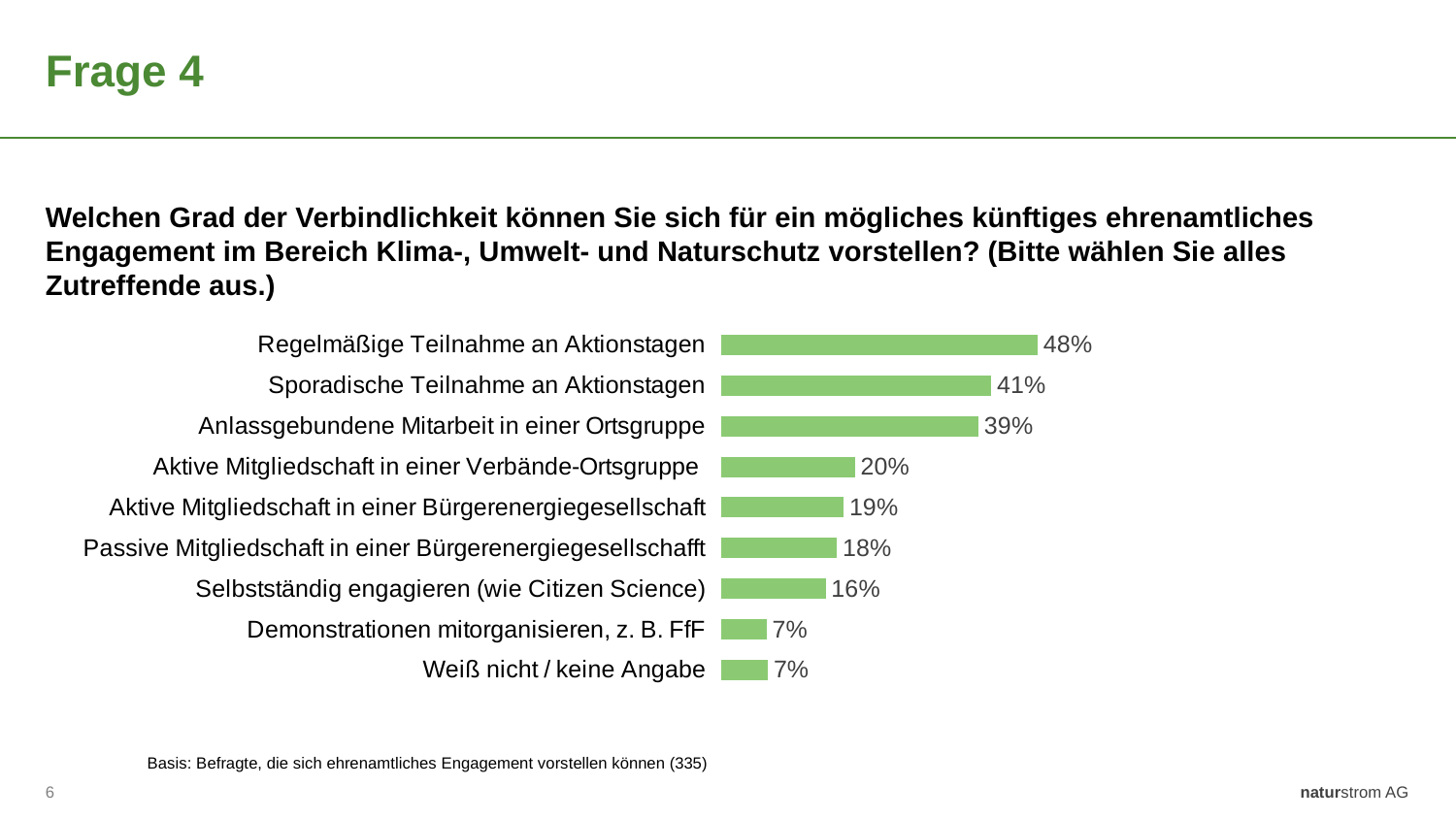
Which is larger: "Sporadische Teilnahme an Aktionstagen" or "Anlassgebundene Mitarbeit in einer Ortsgruppe"? Sporadische Teilnahme an Aktionstagen Which category has the highest value? Regelmäßige Teilnahme an Aktionstagen What is the difference between "Regelmäßige Teilnahme an Aktionstagen" and "Sporadische Teilnahme an Aktionstagen"? 7% How many categories are shown in the chart? 9 Which is larger: "Passive Mitgliedschaft in einer Bürgerenergiegesellschafft" or "Selbstständig engagieren (wie Citizen Science)"? Passive Mitgliedschaft in einer Bürgerenergiegesellschafft What is the lowest value shown in the chart? 7% What is the value for "Regelmäßige Teilnahme an Aktionstagen"? 48% What is the value for "Demonstrationen mitorganisieren, z. B. FfF"? 7% What kind of chart is shown on the slide? Bar chart What is the value for "Aktive Mitgliedschaft in einer Bürgerenergiegesellschaft"? 19% What is the difference between "Anlassgebundene Mitarbeit in einer Ortsgruppe" and "Aktive Mitgliedschaft in einer Verbände-Ortsgruppe"? 19% What is the value for "Selbstständig engagieren (wie Citizen Science)"? 16%